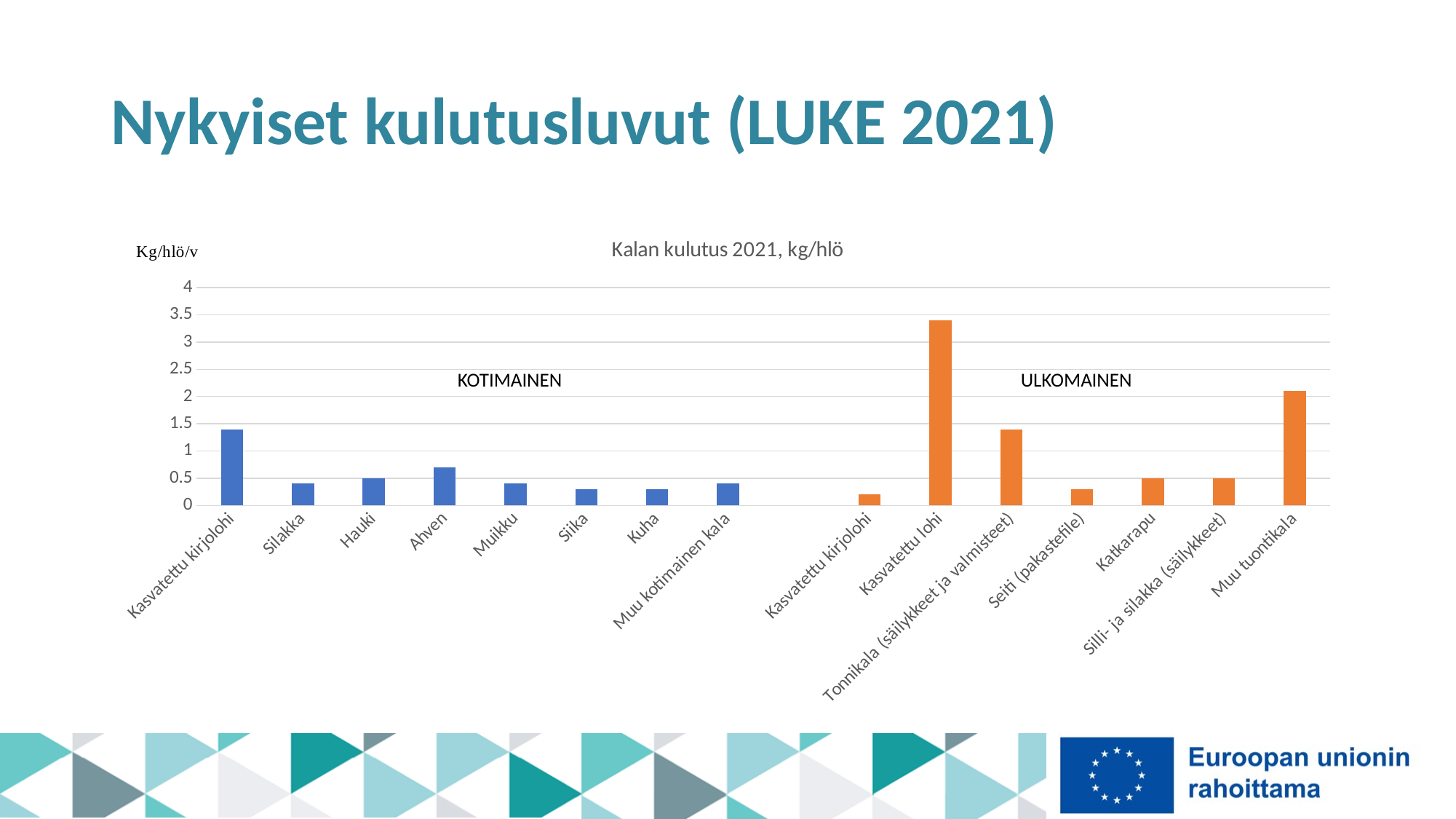
Is the value for Siika greater or less than 0.5? less Which has a larger value, Tonnikala (säilykkeet ja valmisteet) or Seiti (pakastefile)? Tonnikala (säilykkeet ja valmisteet) What are the two group labels written inside the chart area? KOTIMAINEN and ULKOMAINEN How many categories (bars) are plotted in the chart? 15 Which category has the highest value in the chart? Kasvatettu lohi Is the value for Kasvatettu lohi greater or less than 3? greater Which category has the lowest value in the chart? Kasvatettu kirjolohi (ULKOMAINEN group) Which has a larger value, Kasvatettu lohi or Muu tuontikala? Kasvatettu lohi What type of chart is shown on the slide? bar chart Is the value for Ahven greater or less than 0.5? greater What is the title of the chart? Kalan kulutus 2021, kg/hlö